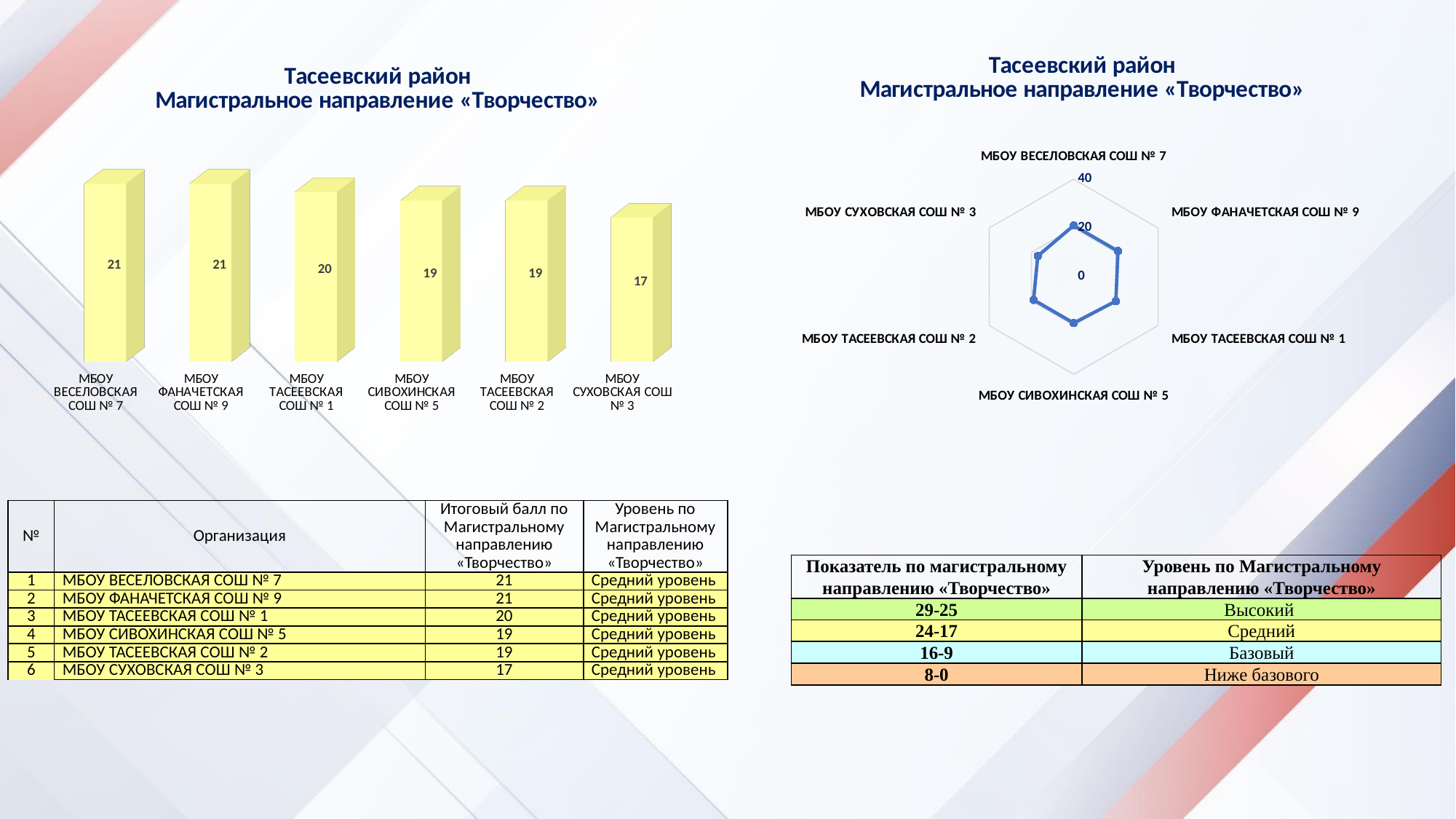
On the bar chart on the left, what is the difference between the values for МБОУ ВЕСЕЛОВСКАЯ СОШ № 7 and МБОУ СУХОВСКАЯ СОШ № 3? 4 What kind of chart is the chart on the right of the slide? radar chart On the bar chart on the left, what is the value for МБОУ ТАСЕЕВСКАЯ СОШ № 1? 20 What kind of chart is the chart on the left of the slide? bar chart How many categories are shown on the bar chart on the left? 6 On the bar chart on the left, do the values rise or fall from left to right? fall How many categories (axes) are shown on the radar chart on the right? 6 On the bar chart on the left, which category has the lowest value? МБОУ СУХОВСКАЯ СОШ № 3 On the radar chart on the right, is the value for МБОУ ВЕСЕЛОВСКАЯ СОШ № 7 greater or less than 40? less On the bar chart on the left, which is larger: the value for МБОУ ФАНАЧЕТСКАЯ СОШ № 9 or the value for МБОУ ТАСЕЕВСКАЯ СОШ № 2? МБОУ ФАНАЧЕТСКАЯ СОШ № 9 On the bar chart on the left, what is the value for МБОУ СИВОХИНСКАЯ СОШ № 5? 19 On the bar chart on the left, what is the value for МБОУ СУХОВСКАЯ СОШ № 3? 17